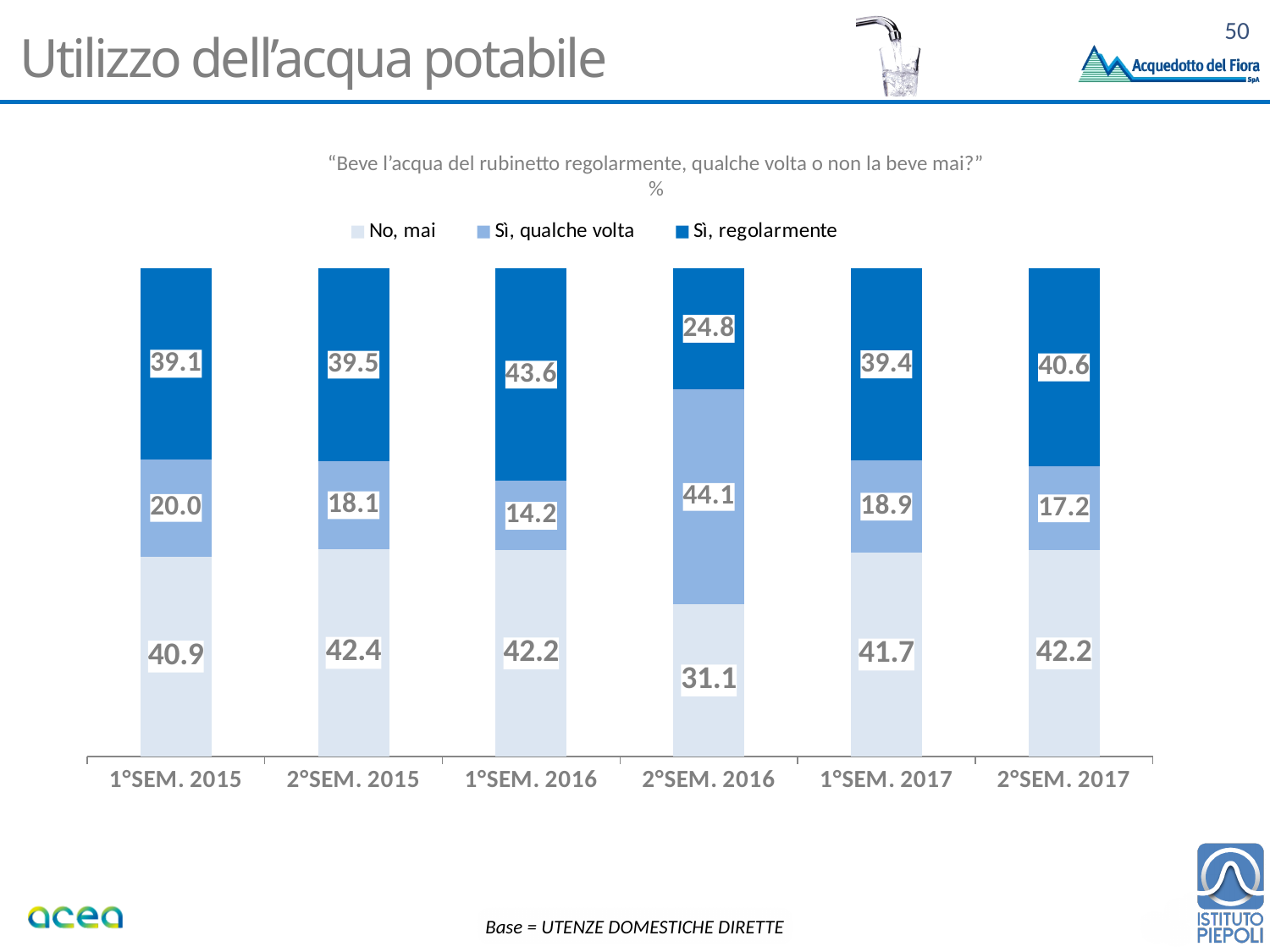
In which period is the "Sì, regolarmente" value lowest? 2°SEM. 2016 What is the total of the stacked bar for 1°SEM. 2015? 100.0 How many series does the legend list? 3 What kind of chart is shown on the slide? Stacked bar chart What is the value for "Sì, qualche volta" in 2°SEM. 2017? 17.2 How many periods are shown on the x axis? 6 In which period is the "Sì, qualche volta" value highest? 2°SEM. 2016 Which legend entry is shown in the darkest blue? Sì, regolarmente What is the difference between the "Sì, regolarmente" values for 2°SEM. 2017 and 1°SEM. 2017? 1.2 Which is larger, the "No, mai" value for 1°SEM. 2015 or for 2°SEM. 2016? 1°SEM. 2015 What is the value for "Sì, regolarmente" in 1°SEM. 2016? 43.6 What is the value for "No, mai" in 2°SEM. 2016? 31.1